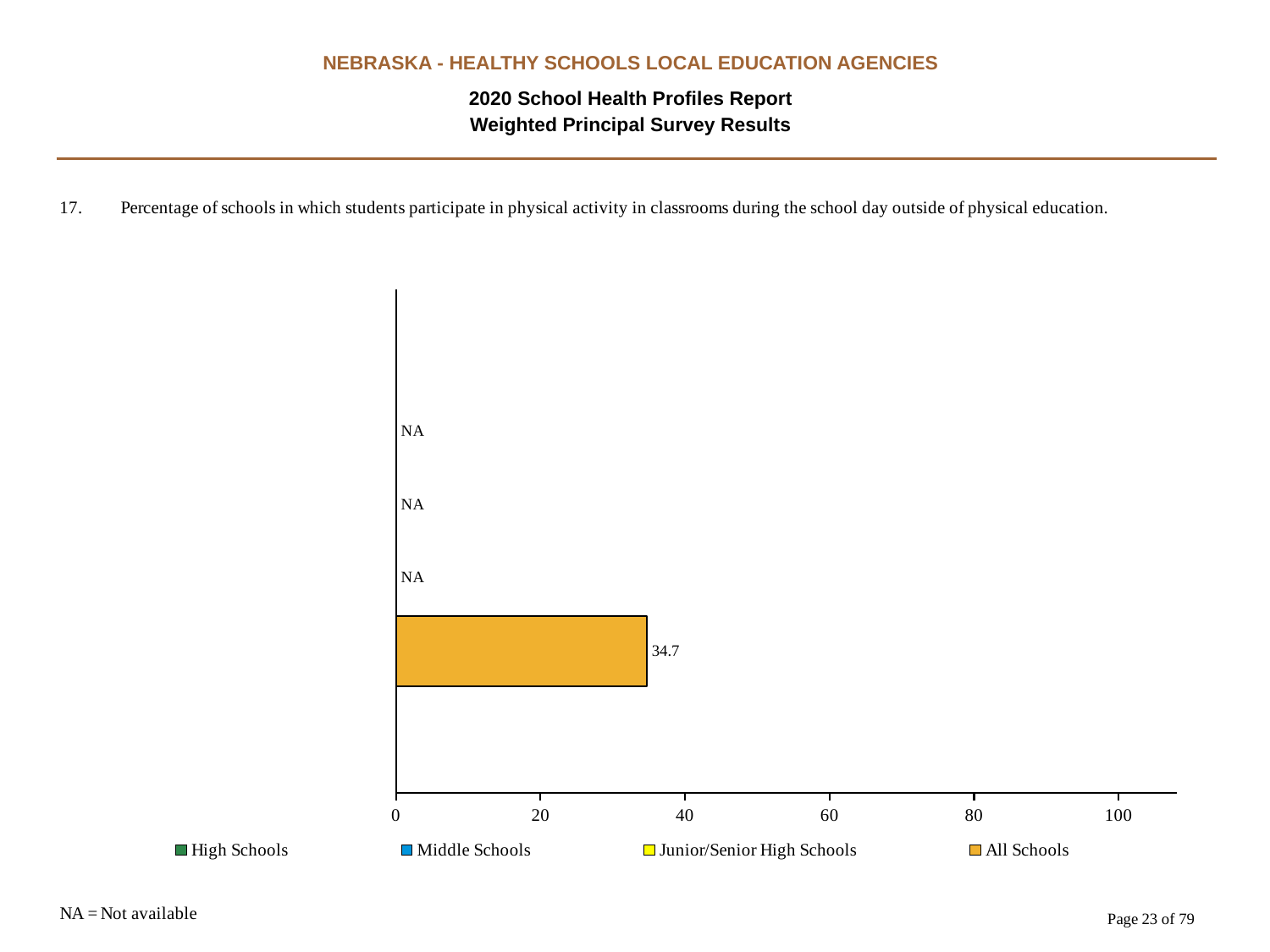
Is the value for All Schools greater or less than 20? greater What is the value for All Schools? 34.7 What kind of chart is shown on the slide? bar chart What does NA stand for according to the slide? Not available What is shown for High Schools on the chart? NA How many series does the legend list? 4 What is the highest value shown on the x axis? 100 What is shown for Middle Schools on the chart? NA What is shown for Junior/Senior High Schools on the chart? NA How many series have a plotted bar with a numeric value? 1 Is the value for All Schools greater or less than 40? less